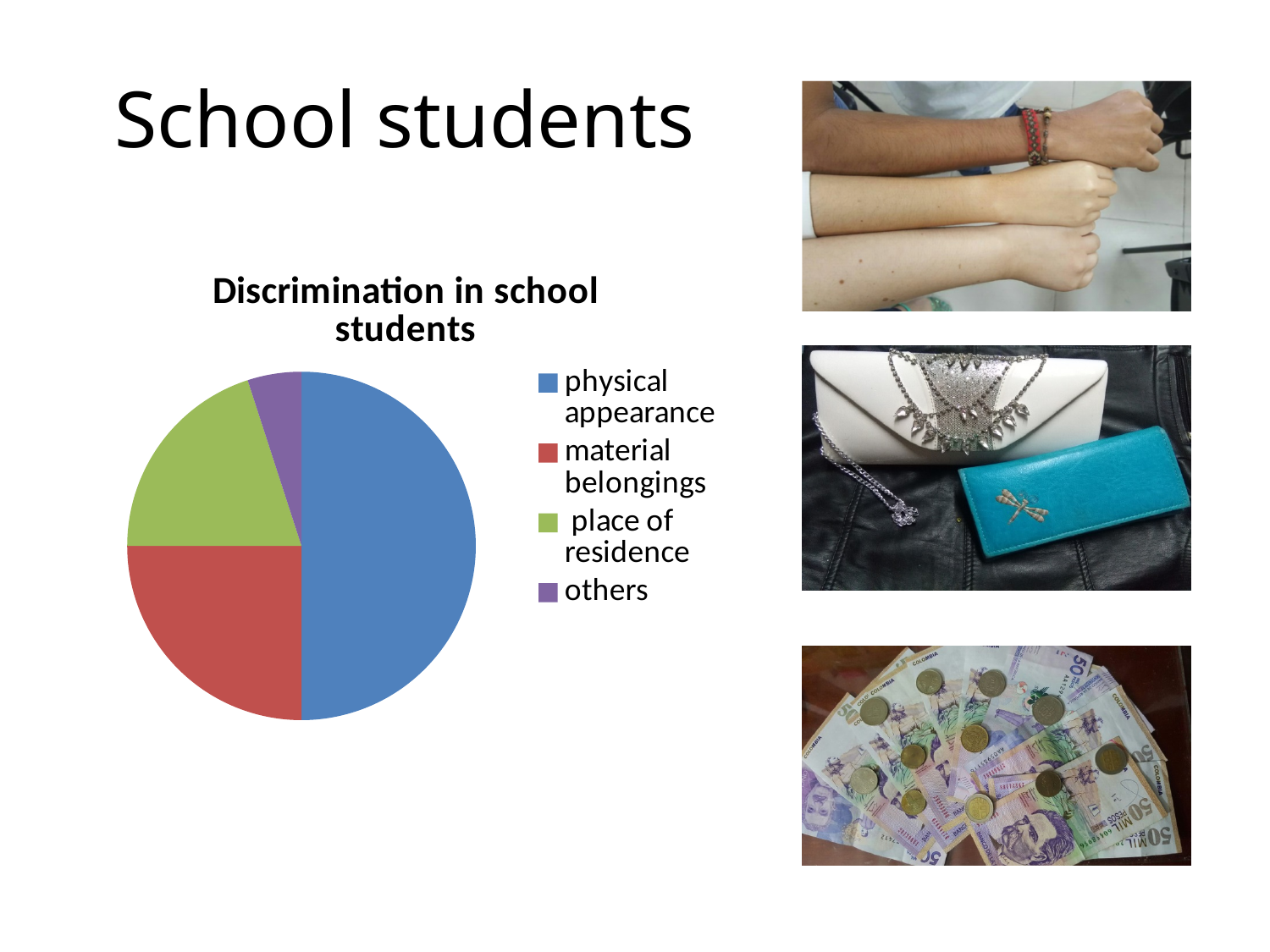
Which category has the largest slice of the pie? physical appearance What kind of chart is shown on the slide? pie chart What is the title of the chart? Discrimination in school students Which slice is larger, material belongings or others? material belongings Which category has the smallest slice of the pie? others Which slice is larger, place of residence or others? place of residence How many categories does the pie chart show? 4 What colour is the slice for physical appearance? blue How many entries does the legend list? 4 Which slice is larger, physical appearance or material belongings? physical appearance